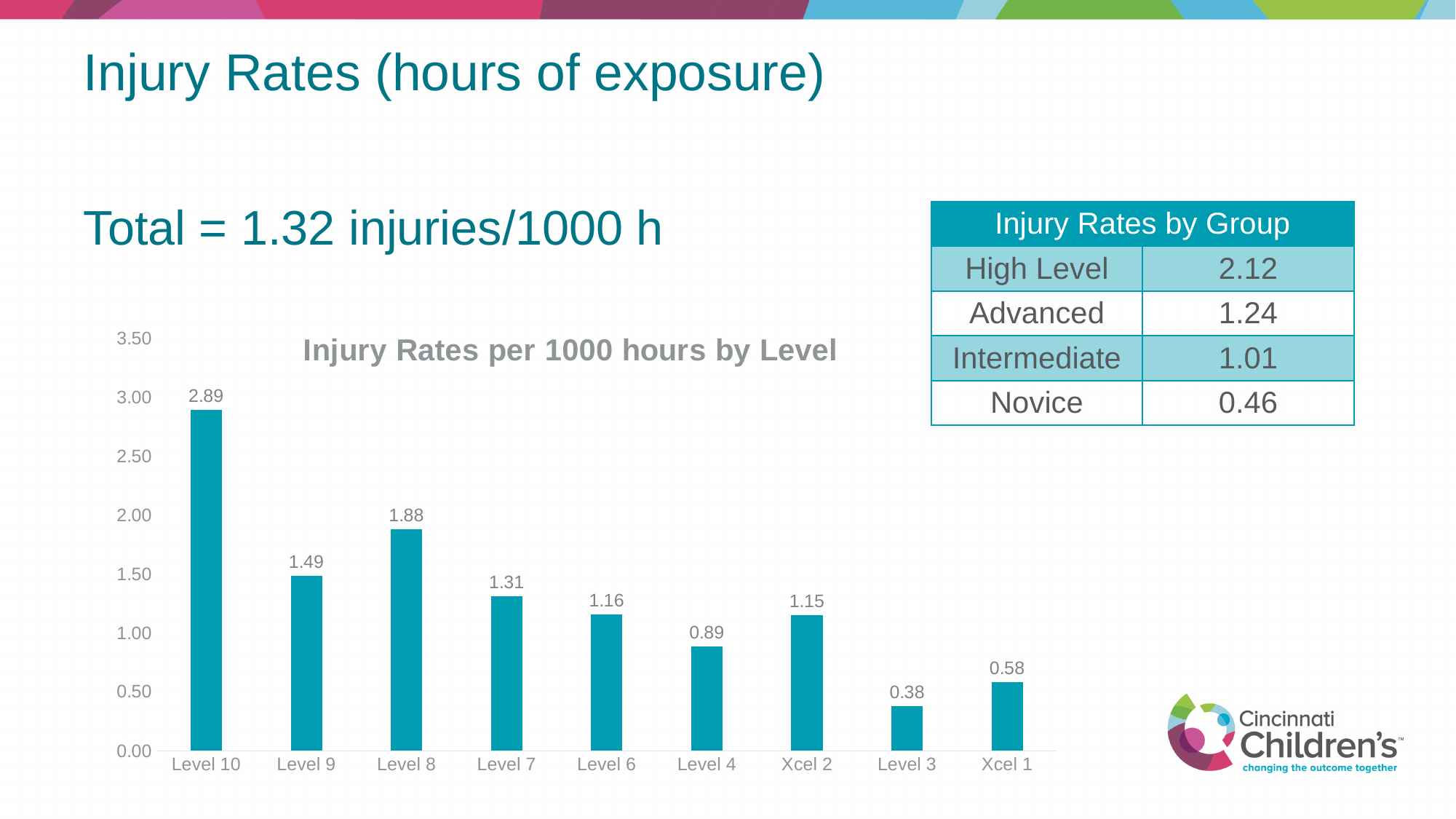
How many levels are shown in the chart? 9 What kind of chart is shown on the slide? bar chart What is the injury rate per 1000 hours for Level 10? 2.89 Which has a higher injury rate, Level 6 or Level 4? Level 6 Which level has the highest injury rate per 1000 hours? Level 10 What is the injury rate per 1000 hours for Xcel 2? 1.15 Is the injury rate for Level 8 greater or less than 1.50? greater What is the injury rate per 1000 hours for Level 3? 0.38 What is the difference between the injury rates for Level 9 and Level 7? 0.18 What is the difference between the injury rates for Level 10 and Level 8? 1.01 What is the title of the chart? Injury Rates per 1000 hours by Level Which level has the lowest injury rate per 1000 hours? Level 3